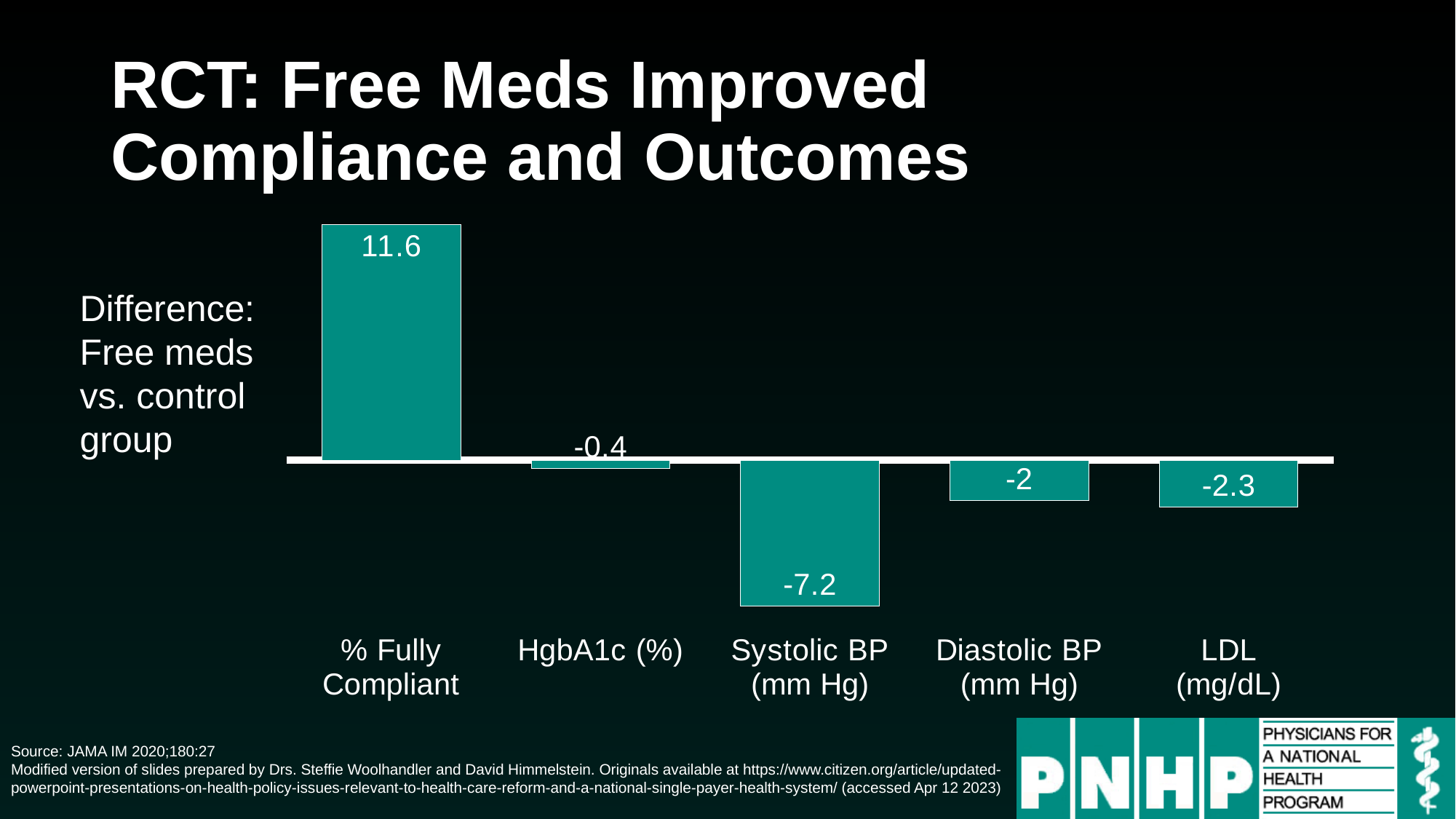
Which is larger, the value for Diastolic BP (mm Hg) or the value for LDL (mg/dL)? Diastolic BP (mm Hg) How many categories have negative values? 4 What is the value for LDL (mg/dL)? -2.3 What kind of chart is shown on the slide? Bar chart What is the value for % Fully Compliant? 11.6 How many categories are shown in the chart? 5 What is the value for Systolic BP (mm Hg)? -7.2 What is the value for Diastolic BP (mm Hg)? -2 Which category has the lowest value? Systolic BP (mm Hg) What is the difference between the values for % Fully Compliant and Systolic BP (mm Hg)? 18.8 What is the value for HgbA1c (%)? -0.4 Which category has the highest value? % Fully Compliant